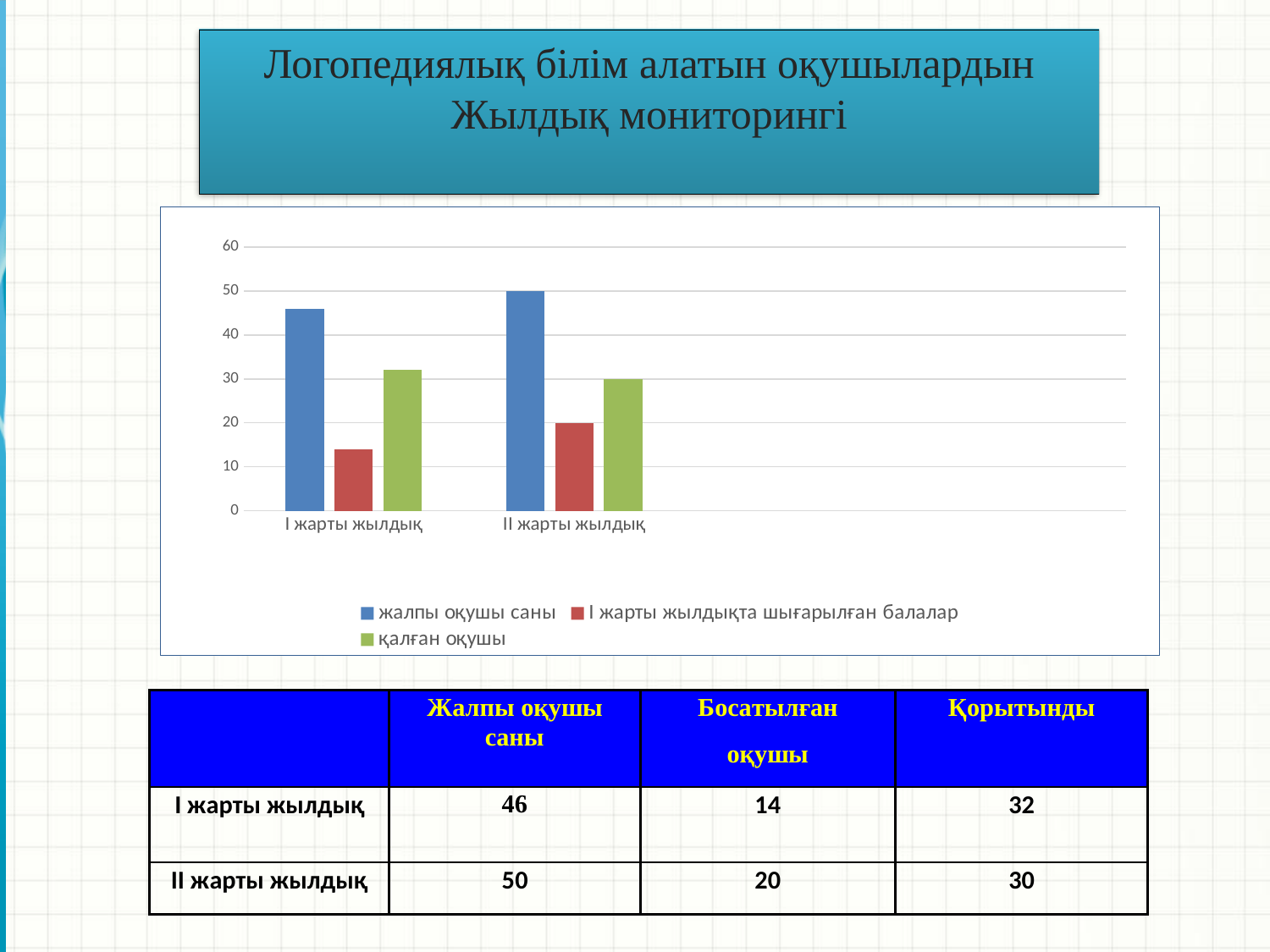
Which category has the higher value for жалпы оқушы саны, I жарты жылдық or II жарты жылдық? II жарты жылдық What kind of chart is shown on the slide? bar chart What is the value of жалпы оқушы саны for II жарты жылдық? 50 Which series has the lowest value in the I жарты жылдық category? I жарты жылдықта шығарылған балалар What colour are the bars for the series қалған оқушы? green Is the value of жалпы оқушы саны for I жарты жылдық greater or less than 40? greater Is the value of I жарты жылдықта шығарылған балалар for I жарты жылдық greater or less than 20? less How many categories are shown on the x axis of the chart? 2 How many series does the chart legend list? 3 What is the value of I жарты жылдықта шығарылған балалар for II жарты жылдық? 20 Does the value of жалпы оқушы саны rise or fall from I жарты жылдық to II жарты жылдық? rise What is the value of қалған оқушы for II жарты жылдық? 30